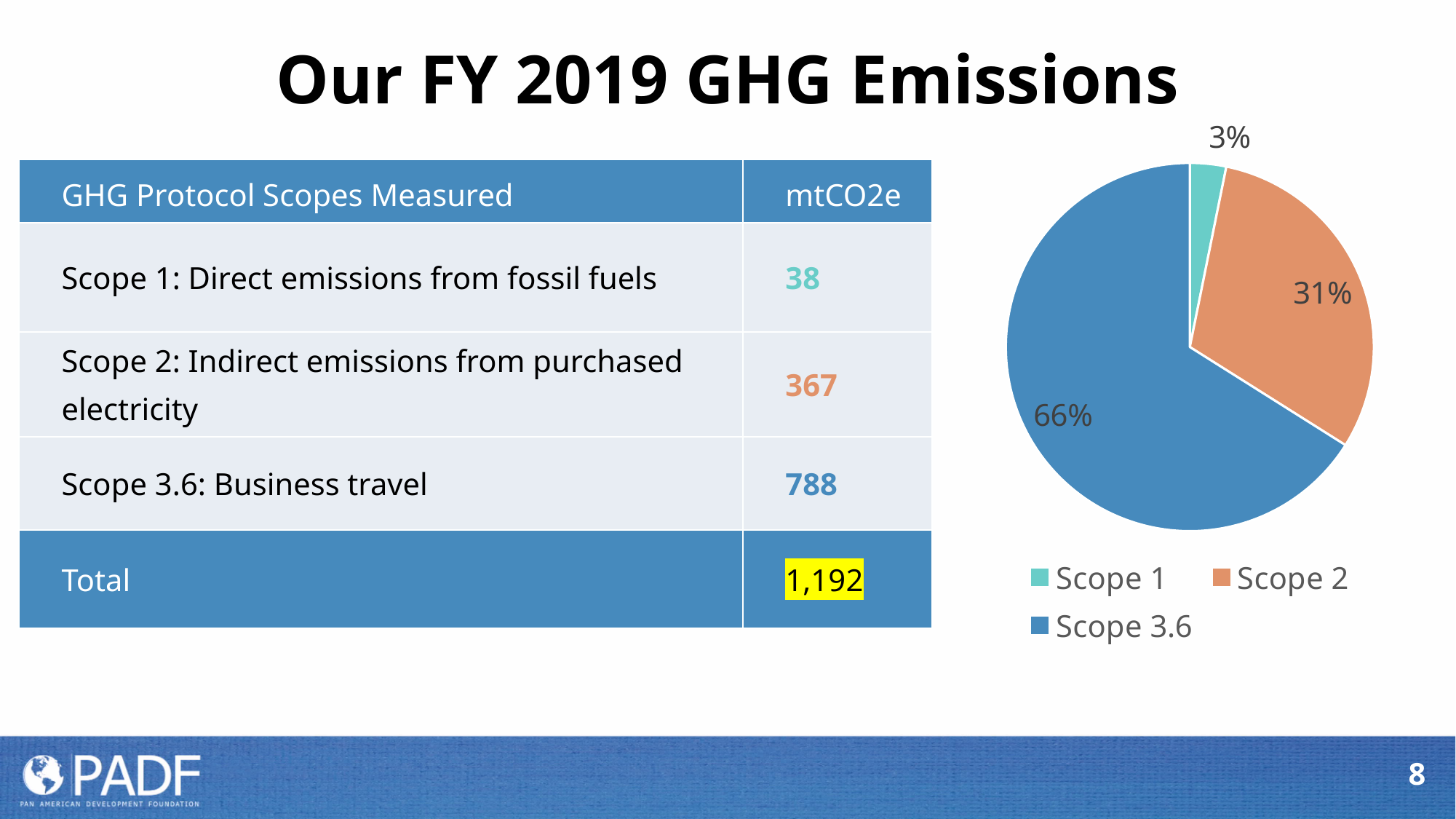
Which slice is larger in the pie chart, Scope 1 or Scope 2? Scope 2 Which scope has the smallest slice in the pie chart? Scope 1 How many slices does the pie chart have? 3 How many entries does the pie chart legend list? 3 What kind of chart is shown on the slide? pie chart What colour is the Scope 2 slice in the pie chart? orange What share of the pie chart does Scope 3.6 represent? 66% What share of the pie chart does Scope 2 represent? 31% What colour is the Scope 1 slice in the pie chart? teal What is the difference in percentage points between the Scope 3.6 slice and the Scope 2 slice? 35 What share of the pie chart does Scope 1 represent? 3% Which scope has the largest slice in the pie chart? Scope 3.6